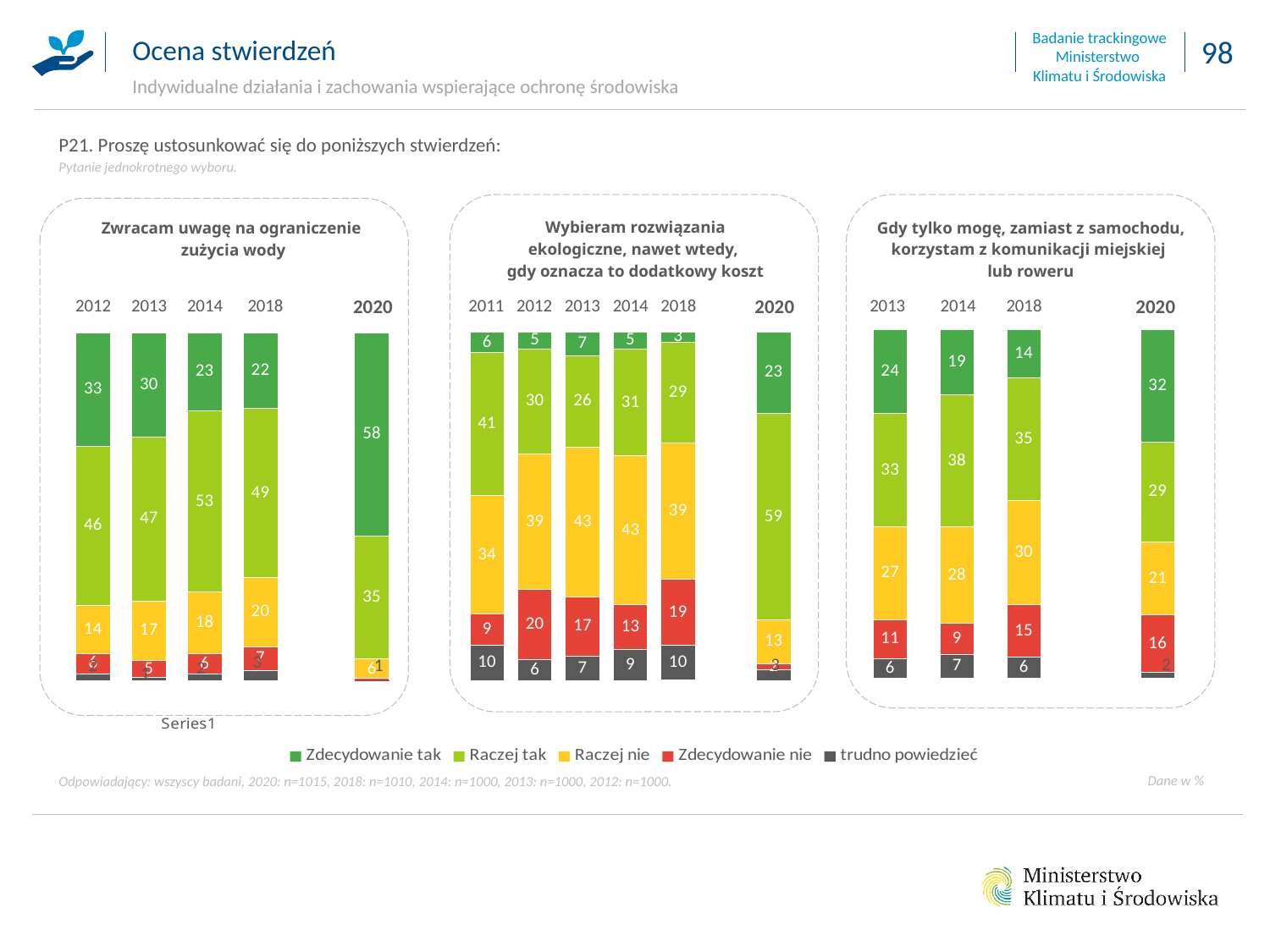
In the chart 'Zwracam uwagę na ograniczenie zużycia wody', what is the 'Zdecydowanie tak' value for 2020? 58 In the chart 'Wybieram rozwiązania ekologiczne, nawet wtedy, gdy oznacza to dodatkowy koszt', what is the difference between the 'Raczej tak' values for 2020 and 2018? 30 In the chart 'Gdy tylko mogę, zamiast z samochodu, korzystam z komunikacji miejskiej lub roweru', which year has the lowest 'Zdecydowanie tak' value? 2018 In the chart 'Gdy tylko mogę, zamiast z samochodu, korzystam z komunikacji miejskiej lub roweru', is the 'Zdecydowanie nie' value for 2020 larger or smaller than for 2013? larger In the chart 'Wybieram rozwiązania ekologiczne, nawet wtedy, gdy oznacza to dodatkowy koszt', what is the 'Zdecydowanie nie' value for 2012? 20 In the chart 'Zwracam uwagę na ograniczenie zużycia wody', what is the 'Raczej tak' value for 2014? 53 What kind of chart is used on this slide? Stacked bar chart In the chart 'Wybieram rozwiązania ekologiczne, nawet wtedy, gdy oznacza to dodatkowy koszt', how many years are shown? 6 In the chart 'Wybieram rozwiązania ekologiczne, nawet wtedy, gdy oznacza to dodatkowy koszt', what is the 'Raczej nie' value for 2013? 43 In the chart 'Zwracam uwagę na ograniczenie zużycia wody', which year has the highest 'Zdecydowanie tak' value? 2020 How many series does the legend list? 5 In the chart 'Gdy tylko mogę, zamiast z samochodu, korzystam z komunikacji miejskiej lub roweru', what is the 'Raczej tak' value for 2014? 38